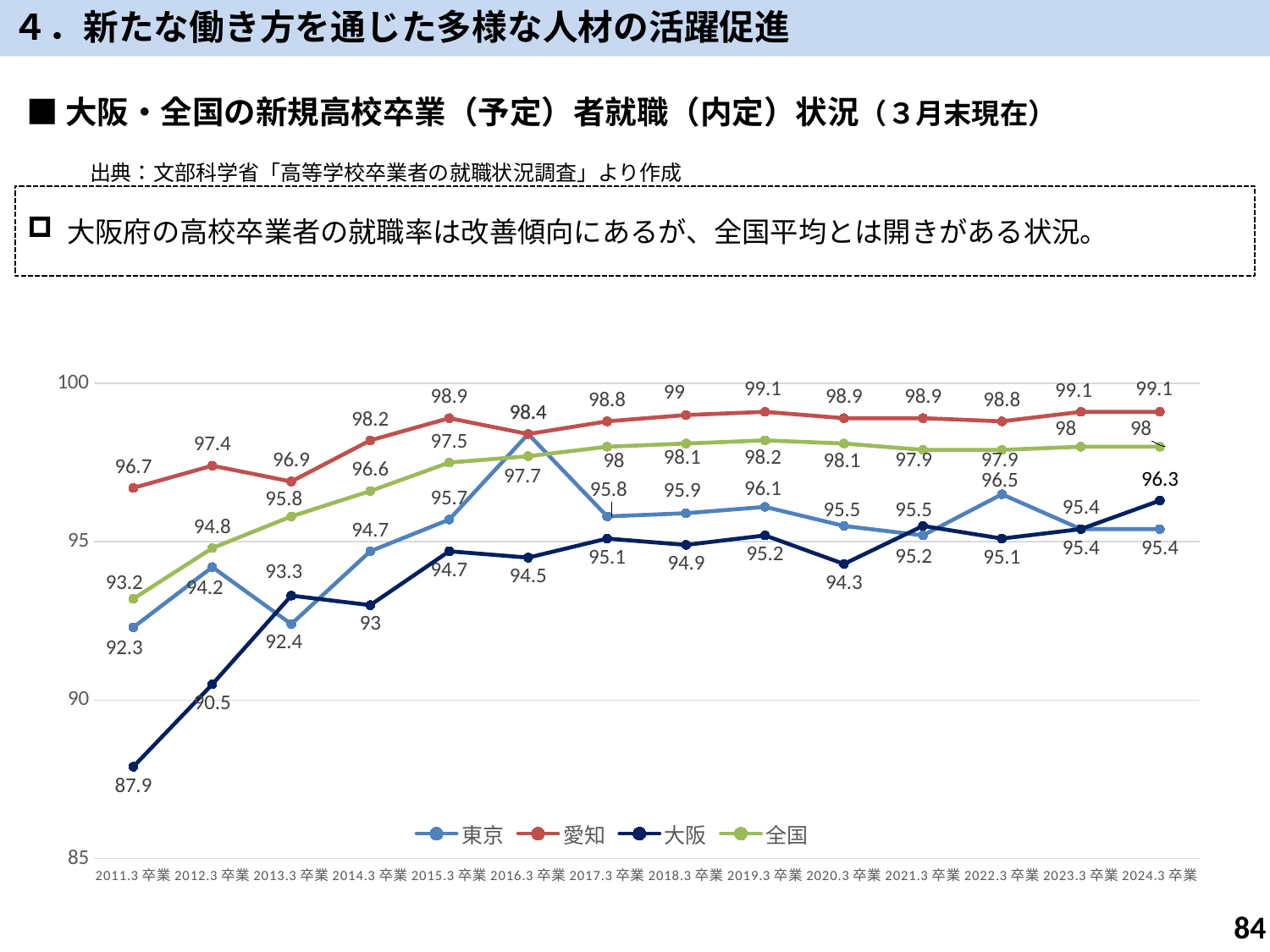
What is the value for 全国 at 2019.3卒業? 98.2 What is the value for 大阪 at 2011.3卒業? 87.9 What is the value for 愛知 at 2015.3卒業? 98.9 In which year is the value for 東京 highest? 2016.3卒業 How many series does the legend list? 4 How many graduation years are plotted along the x axis? 14 What is the value for 大阪 at 2024.3卒業? 96.3 What kind of chart is shown on the slide? line chart At 2024.3卒業, which is larger, 東京 or 大阪? 大阪 What is the difference between 愛知 and 大阪 at 2024.3卒業? 2.8 Is the value for 大阪 at 2011.3卒業 greater or less than 90? less In which year is the value for 大阪 lowest? 2011.3卒業